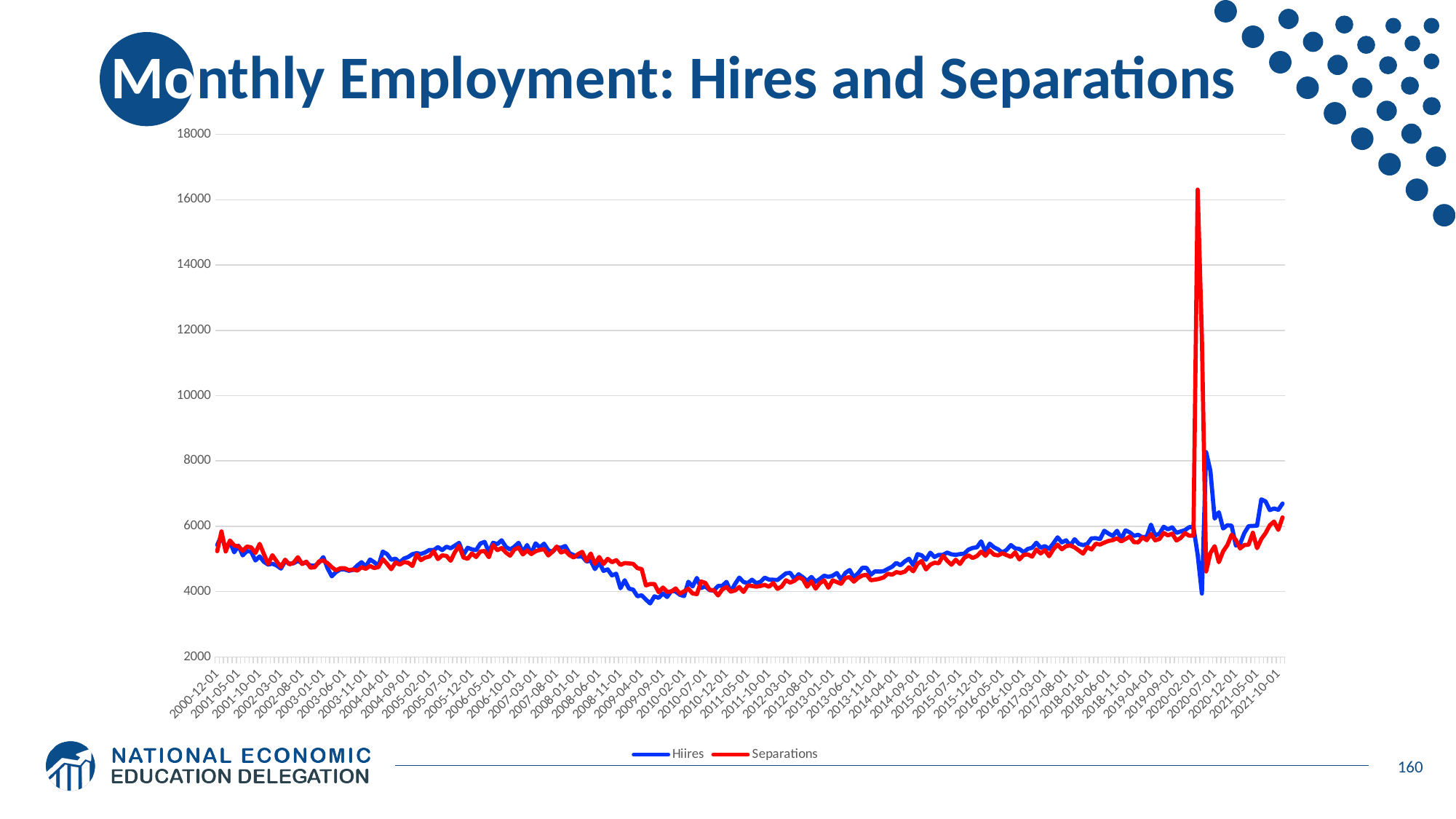
Is the value of the Separations series at 2000-12-01 greater or less than 4000? greater Which series spikes higher in 2020, Hiires or Separations? Separations How many series does the legend list? 2 Is the lowest value of the Hiires series around 2009 greater or less than 4000? less What is the title of the chart on the slide? Monthly Employment: Hires and Separations Is the peak value of the Hiires series in 2020 greater or less than 6000? greater Do the Hiires values generally rise or fall between 2007-08-01 and 2009-04-01? fall Do the Hiires values generally rise or fall between 2009-09-01 and 2019-09-01? rise What are the two series named in the legend? Hiires and Separations Which series reaches the highest value on the chart? Separations What kind of chart is shown on the slide? line chart